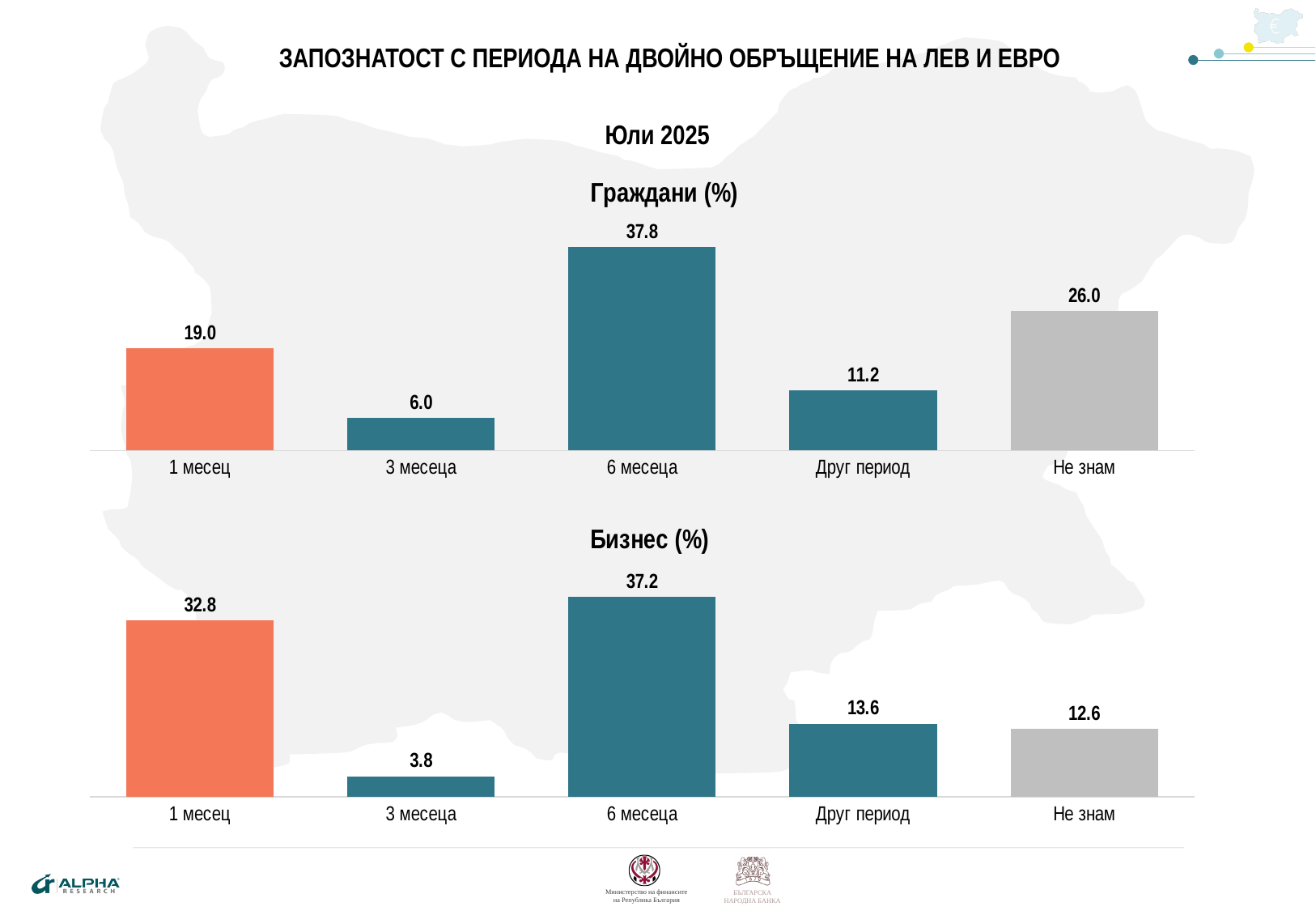
In the "Граждани (%)" chart, what is the difference between "6 месеца" and "Не знам"? 11.8 How many categories are shown in the "Бизнес (%)" chart? 5 In the "Бизнес (%)" chart, what is the value for "1 месец"? 32.8 Which chart has the larger value for "Не знам": "Граждани (%)" or "Бизнес (%)"? Граждани (%) In the "Граждани (%)" chart, which category has the lowest value? 3 месеца In the "Граждани (%)" chart, which is larger: "1 месец" or "Друг период"? 1 месец Which month and year is shown above the charts? Юли 2025 In the "Бизнес (%)" chart, which category has the highest value? 6 месеца In the "Бизнес (%)" chart, what is the difference between "Друг период" and "Не знам"? 1.0 In the "Бизнес (%)" chart, what is the value for "3 месеца"? 3.8 In the "Граждани (%)" chart, what is the value for "6 месеца"? 37.8 What kind of chart is the "Граждани (%)" chart? Bar chart